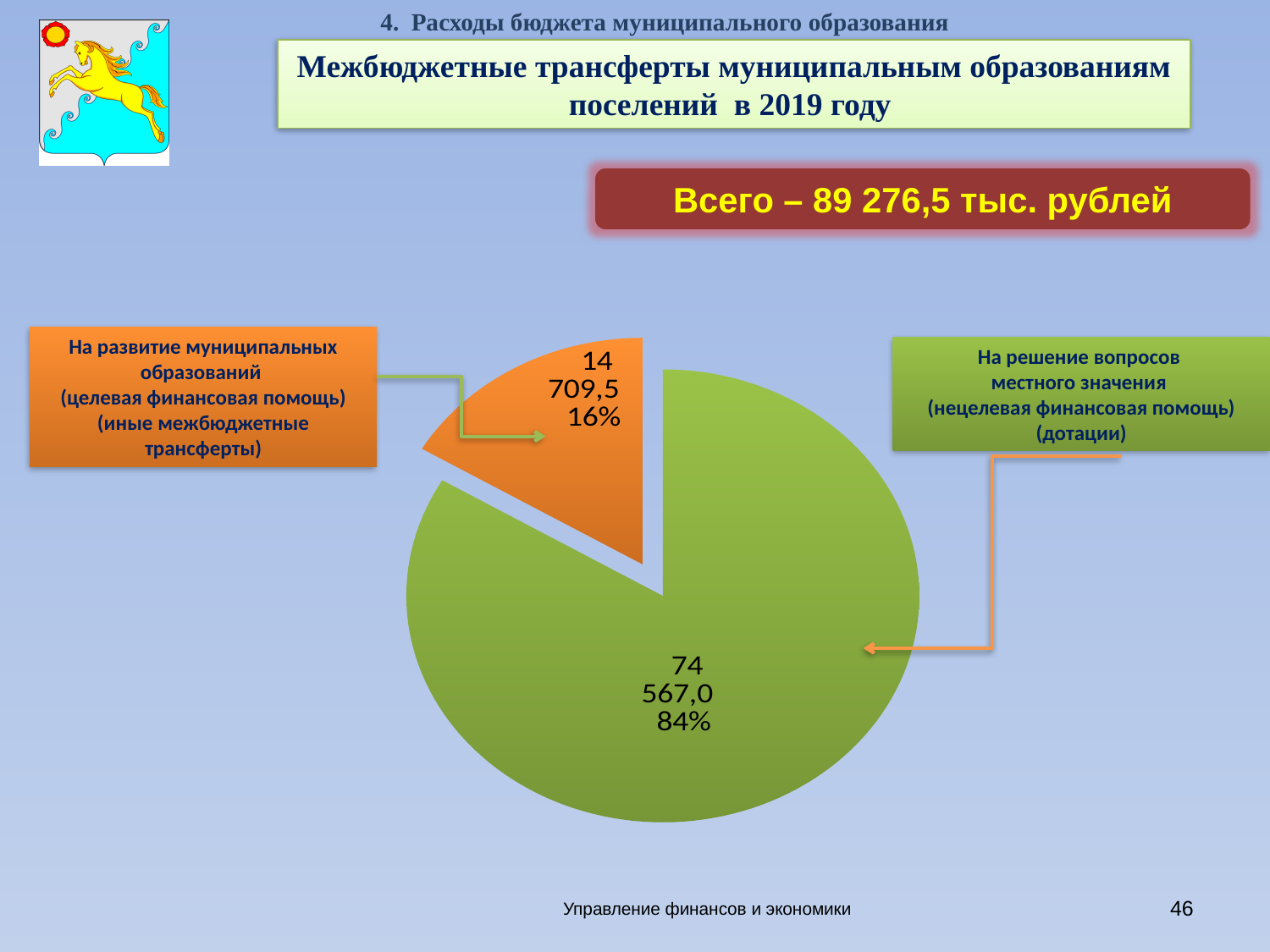
What colour is the slice for 'На развитие муниципальных образований (иные межбюджетные трансферты)'? orange Which category has the smallest slice in the pie chart? На развитие муниципальных образований (целевая финансовая помощь) (иные межбюджетные трансферты) Which is larger: the slice for 'дотации' or the slice for 'иные межбюджетные трансферты'? дотации What share of the pie does the slice for 'На решение вопросов местного значения (дотации)' represent? 84% What is the value of the slice for 'На решение вопросов местного значения (нецелевая финансовая помощь) (дотации)'? 74 567,0 What kind of chart is shown on the slide? pie chart What total amount is stated on the slide for the intergovernmental transfers in 2019? 89 276,5 тыс. рублей Which category has the largest slice in the pie chart? На решение вопросов местного значения (нецелевая финансовая помощь) (дотации) What share of the pie does the slice for 'На развитие муниципальных образований (иные межбюджетные трансферты)' represent? 16% How many slices does the pie chart have? 2 What is the value of the slice for 'На развитие муниципальных образований (целевая финансовая помощь) (иные межбюджетные трансферты)'? 14 709,5 What is the difference in percentage points between the two slices of the pie chart? 68